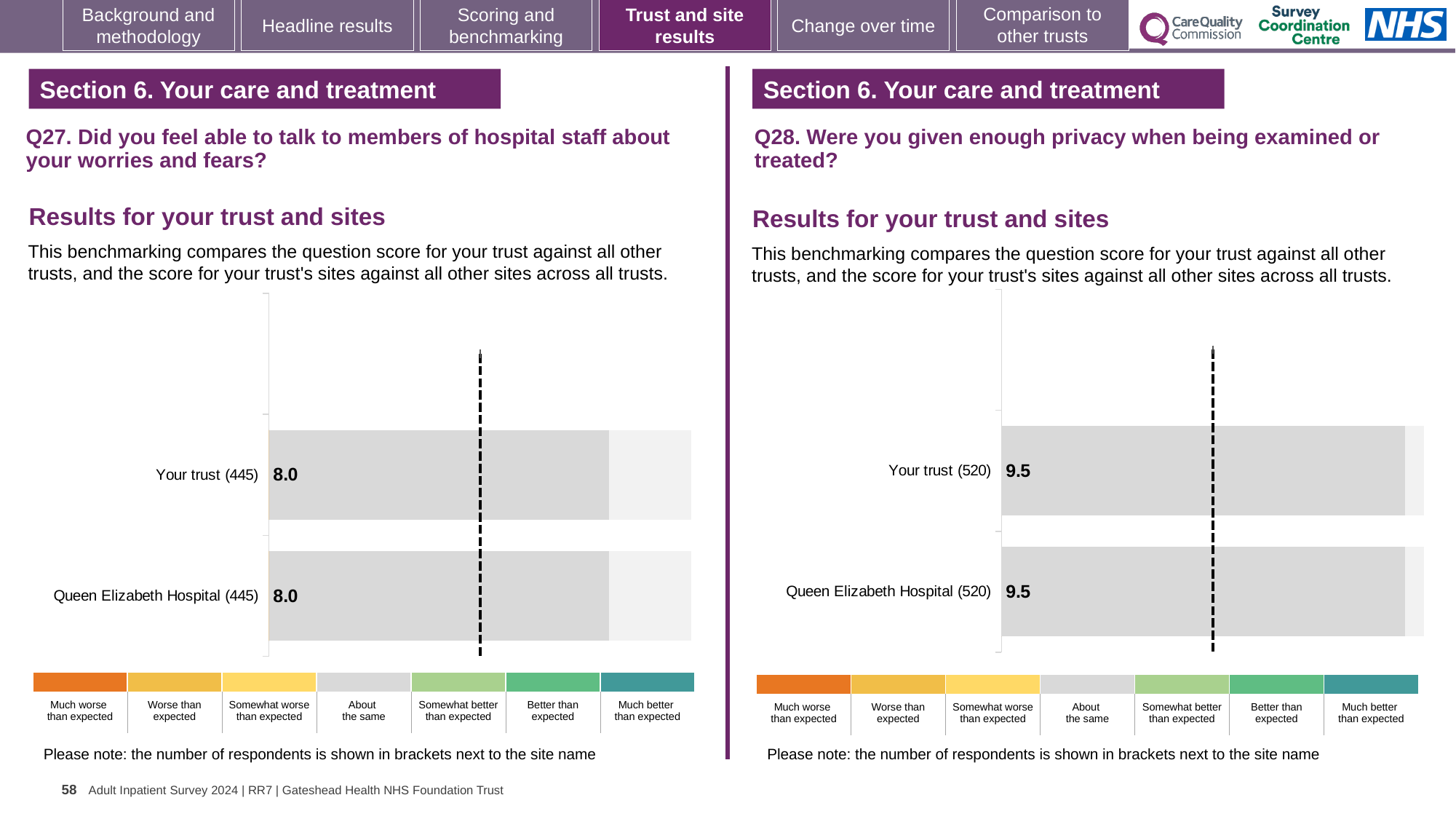
Is the Your trust score in the Q28 chart on the right larger or smaller than the Your trust score in the Q27 chart on the left? Larger How many bars are plotted in the Q28 chart on the right? 2 In the Q27 chart on the left, what is the score for Queen Elizabeth Hospital? 8.0 In the Q28 chart on the right, what is the score for Queen Elizabeth Hospital? 9.5 What type of chart is used for the Q27 results on the left? Bar chart In the Q27 chart on the left, what is the difference between the score for Your trust and the score for Queen Elizabeth Hospital? 0.0 In the Q28 chart on the right, what is the difference between the score for Your trust and the score for Queen Elizabeth Hospital? 0.0 In the Q28 chart on the right, what is the score for Your trust? 9.5 In the Q27 chart on the left, how many respondents are shown in brackets next to Your trust? 445 In the Q28 chart on the right, how many respondents are shown in brackets next to Queen Elizabeth Hospital? 520 How many bars are plotted in the Q27 chart on the left? 2 In the Q27 chart on the left, what is the score for Your trust? 8.0